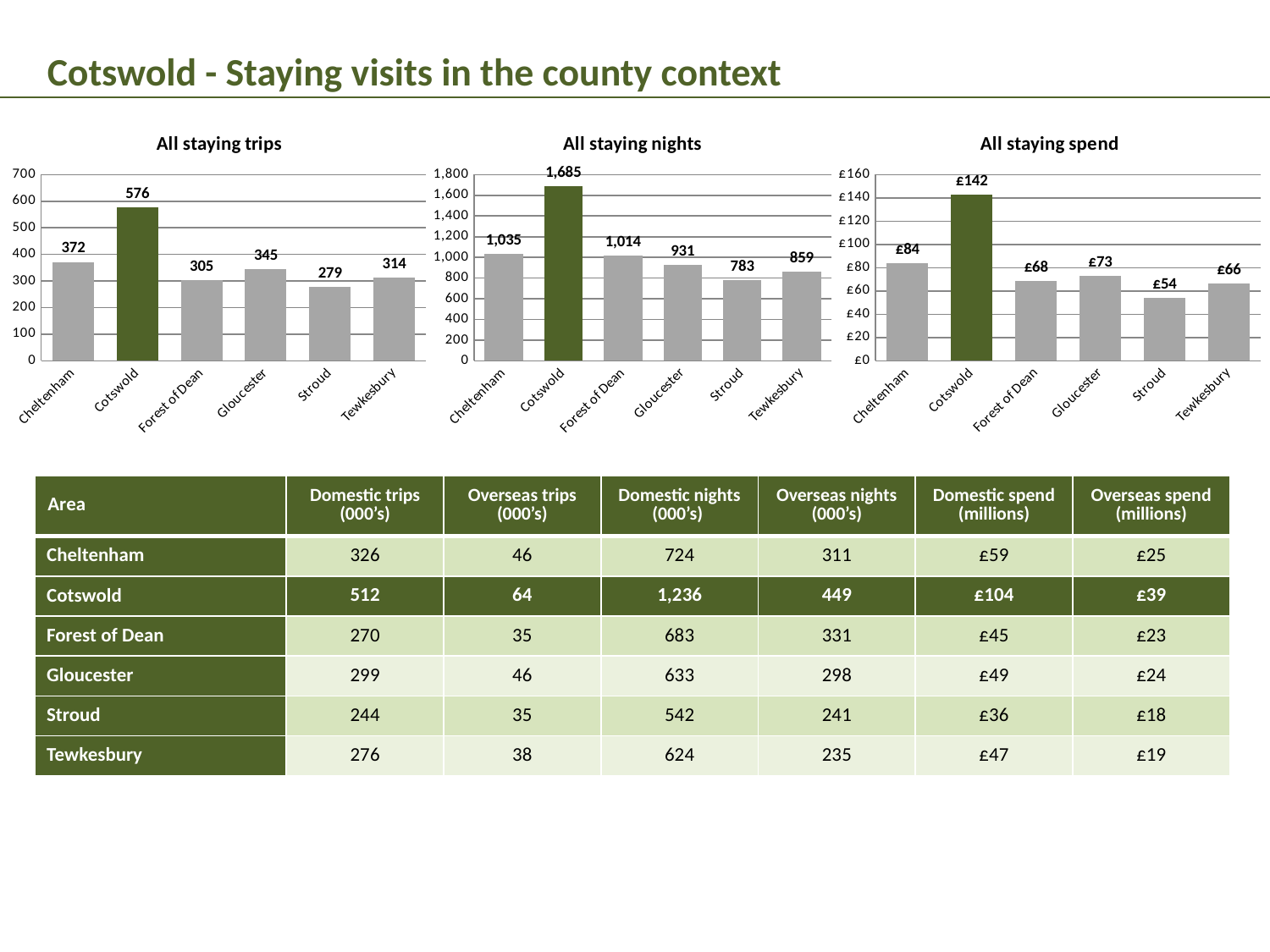
In the 'All staying nights' chart, what is the difference between Cotswold and Stroud? 902 In the 'All staying spend' chart, which is larger, Cheltenham or Forest of Dean? Cheltenham In the 'All staying trips' chart, which area has the lowest value? Stroud How many areas are shown in the 'All staying trips' chart? 6 In the 'All staying trips' chart, what is the value for Cotswold? 576 In the 'All staying nights' chart, which area has the highest value? Cotswold In the 'All staying nights' chart, is the value for Tewkesbury greater or less than 1,000? less In the 'All staying spend' chart, which area has the lowest value? Stroud What type of chart is the 'All staying spend' chart? Bar chart In the 'All staying spend' chart, what is the value for Gloucester? £73 In the 'All staying nights' chart, what is the value for Cheltenham? 1,035 In the 'All staying trips' chart, what is the difference between Gloucester and Tewkesbury? 31